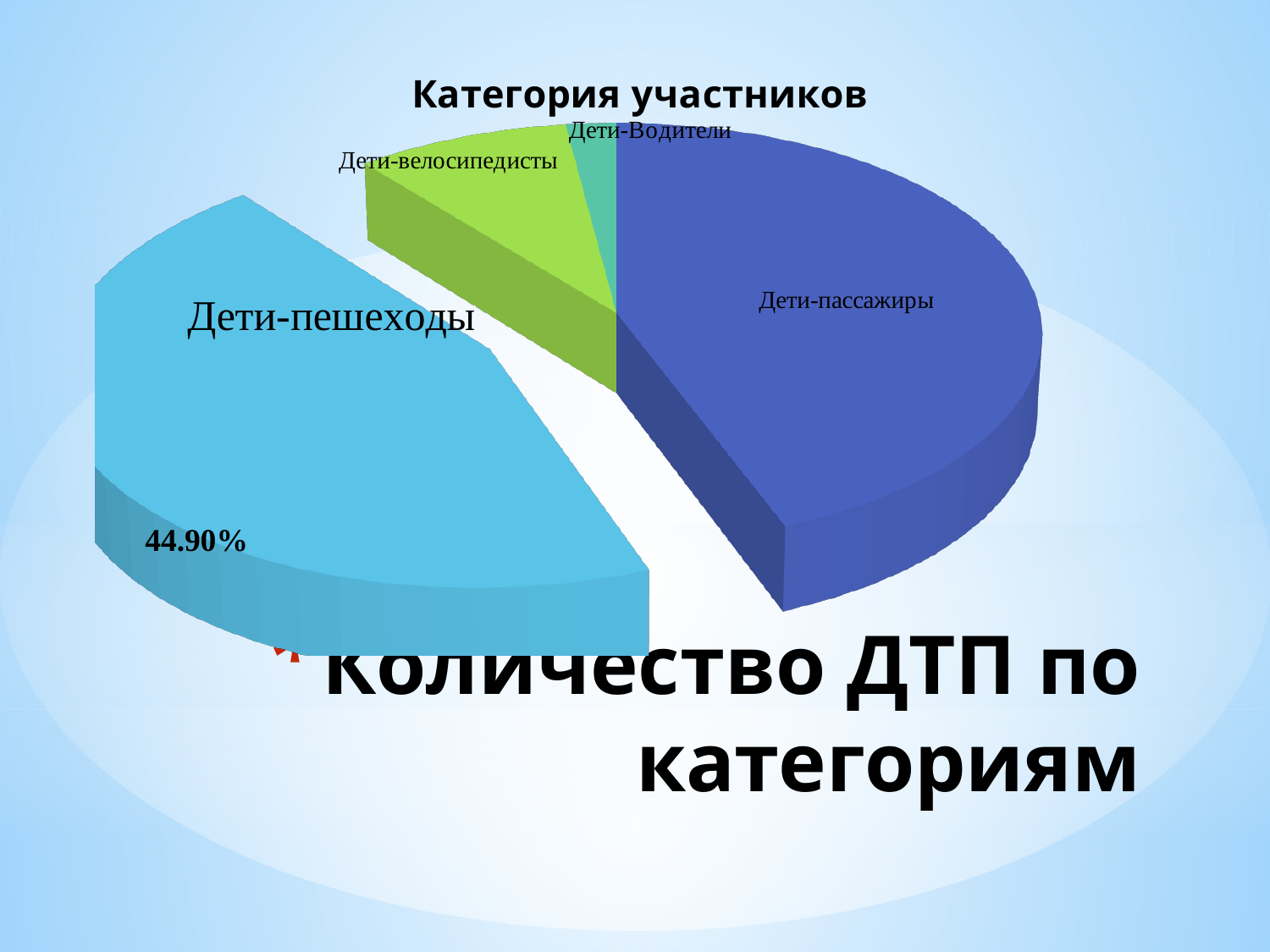
What colour is the Дети-пассажиры slice? dark blue What share of the pie does Дети-пешеходы have? 44.90% Which category's slice is pulled out (exploded) from the rest of the pie? Дети-пешеходы What kind of chart is shown on the slide? pie chart Which slice is larger, Дети-велосипедисты or Дети-Водители? Дети-велосипедисты Which category has the smallest slice of the pie? Дети-Водители Which slice is larger, Дети-пассажиры or Дети-Водители? Дети-пассажиры What is the title of the chart? Категория участников How many categories (slices) does the pie chart have? 4 Which slice is larger, Дети-пешеходы or Дети-велосипедисты? Дети-пешеходы